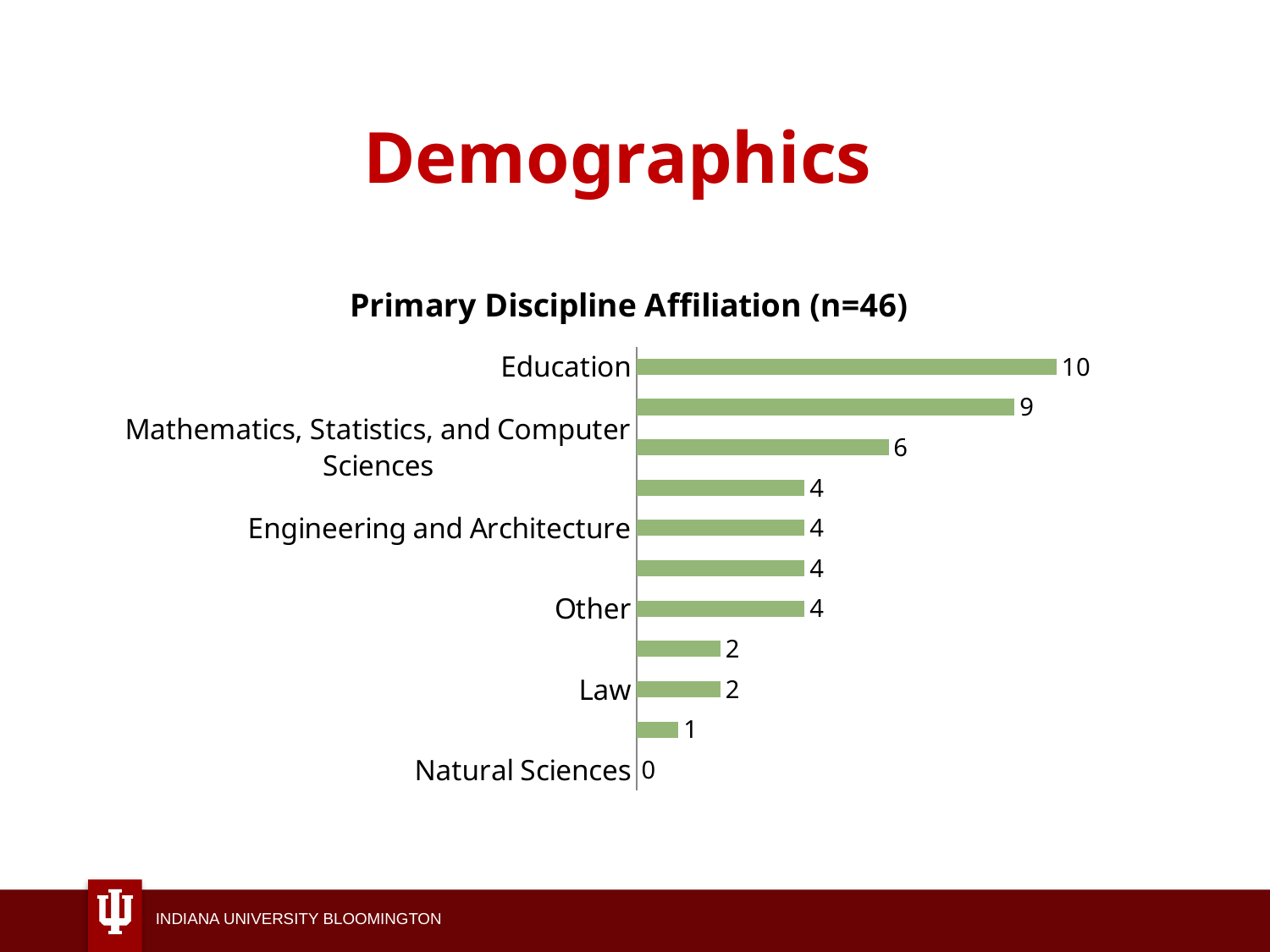
What is the value for Natural Sciences? 0 Which discipline has the highest value in the chart? Education What kind of chart is shown on the slide? Bar chart What is the difference between the values for Education and Mathematics, Statistics, and Computer Sciences? 4 What is the value for Other? 4 What is the value for Education in the Primary Discipline Affiliation chart? 10 What is the value for Engineering and Architecture? 4 What is the title of the chart? Primary Discipline Affiliation (n=46) Which discipline has the lowest value in the chart? Natural Sciences What is the value for Law? 2 What is the value for Mathematics, Statistics, and Computer Sciences? 6 Which is larger, the value for Law or the value for Engineering and Architecture? Engineering and Architecture